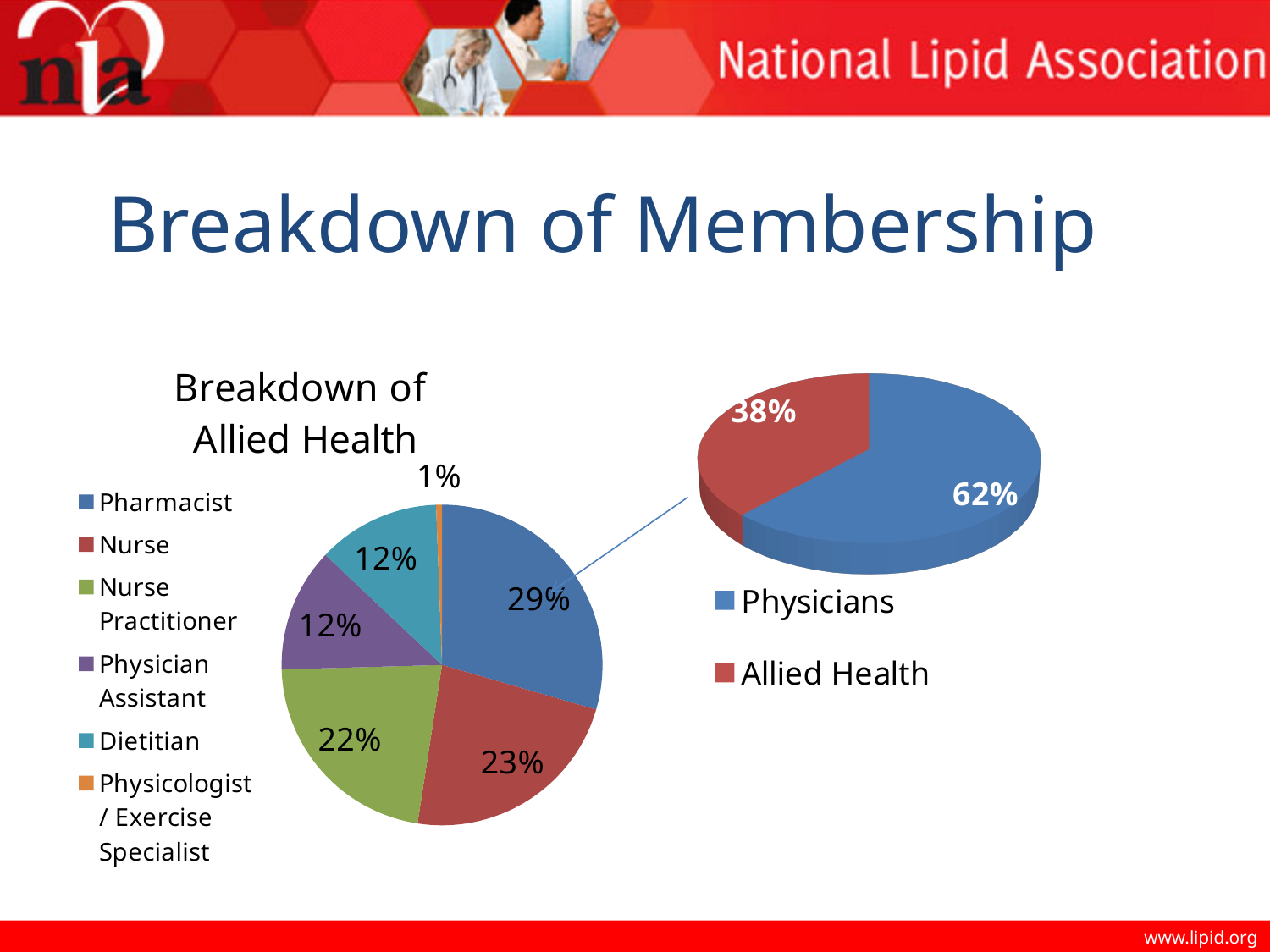
In the 'Breakdown of Allied Health' pie chart, which is larger, Nurse or Dietitian? Nurse In the 'Breakdown of Allied Health' pie chart, which category has the smallest share? Physicologist / Exercise Specialist What type of chart is the 'Breakdown of Allied Health' chart? Pie chart In the pie chart on the right, what share is Physicians? 62% In the 'Breakdown of Allied Health' pie chart, what share is Physicologist / Exercise Specialist? 1% In the 'Breakdown of Allied Health' pie chart, which category has the largest share? Pharmacist In the 'Breakdown of Allied Health' pie chart, how many categories does the legend list? 6 In the 'Breakdown of Allied Health' pie chart, what share is Pharmacist? 29% In the 'Breakdown of Allied Health' pie chart, what is the difference between the Pharmacist share and the Nurse share? 6% In the pie chart on the right, what is the difference between the Physicians share and the Allied Health share? 24%